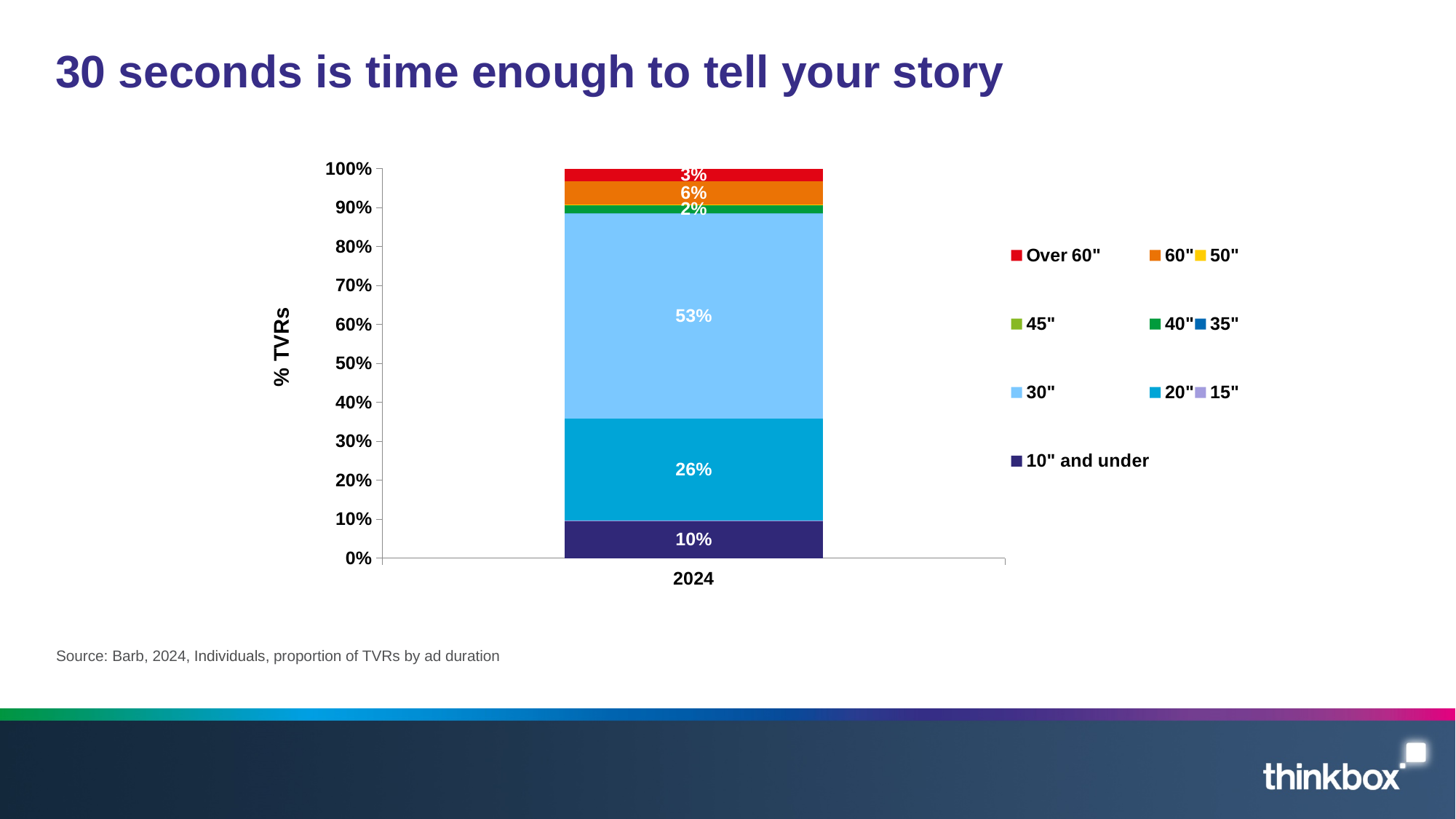
What percentage of TVRs is shown for the 30" segment in 2024? 53% What is the label on the vertical axis of the chart? % TVRs How many series does the legend list? 10 What is the combined share of the 30" and 20" segments? 79% How many percentage points larger is the 30" segment than the 20" segment? 27 percentage points What kind of chart is shown on the slide? Stacked bar chart Which is larger, the 20" segment or the 10" and under segment? 20" What percentage is shown for the Over 60" segment? 3% What percentage is shown for the 60" segment? 6% Which ad duration accounts for the largest share of TVRs in 2024? 30" What percentage of TVRs is shown for the 20" segment? 26% What value is labelled on the 10" and under segment? 10%